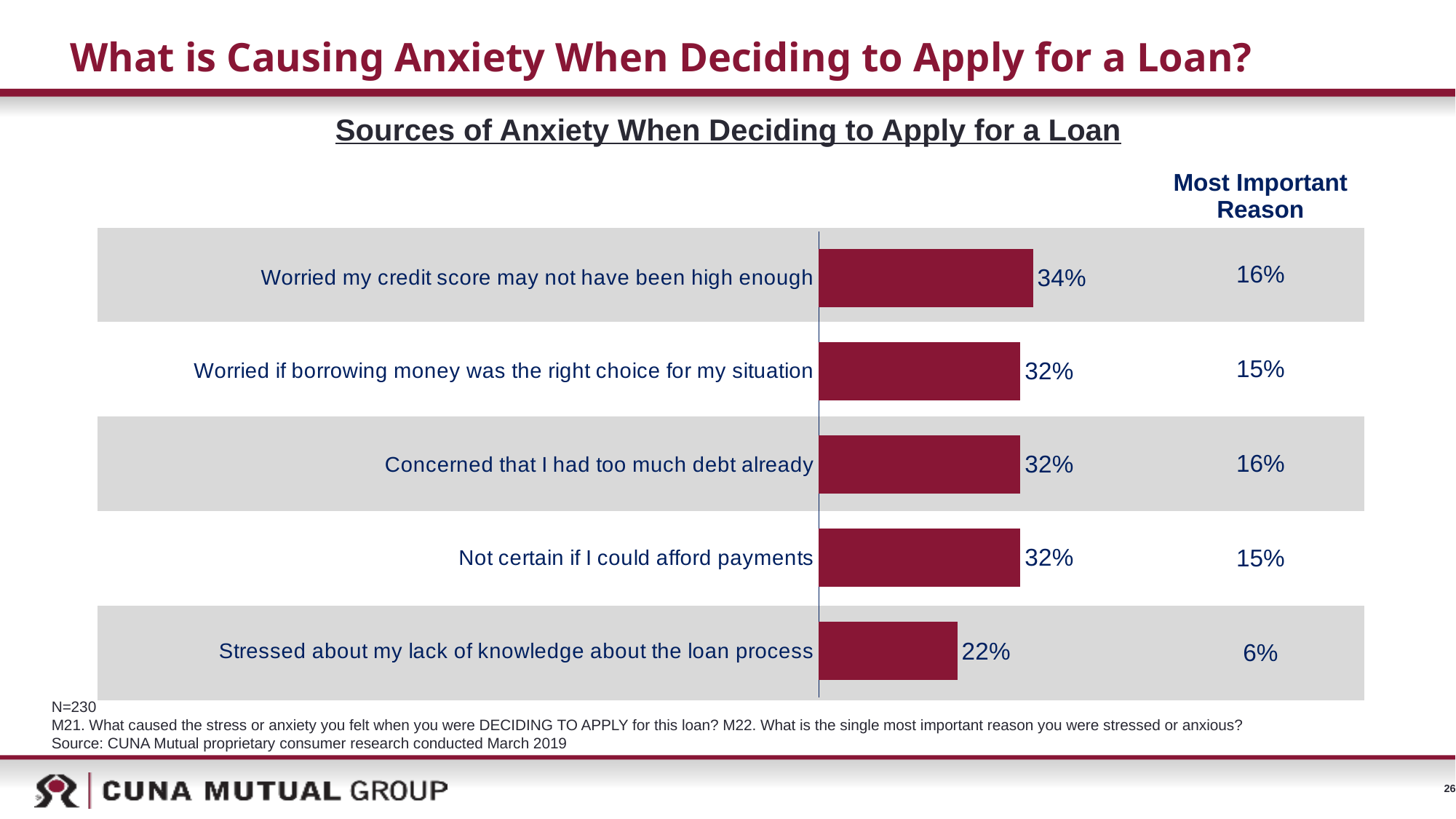
What is the 'Most Important Reason' value for 'Stressed about my lack of knowledge about the loan process'? 6% Which is larger: the bar value for 'Not certain if I could afford payments' or for 'Stressed about my lack of knowledge about the loan process'? Not certain if I could afford payments Which source of anxiety has the lowest percentage in the bar chart? Stressed about my lack of knowledge about the loan process What percentage of respondents were stressed about their lack of knowledge about the loan process? 22% What is the difference between the bar values for 'Worried my credit score may not have been high enough' and 'Stressed about my lack of knowledge about the loan process'? 12 percentage points Which source of anxiety has the highest percentage in the bar chart? Worried my credit score may not have been high enough What is the sample size (N) noted below the chart? N=230 What is the title of the chart? Sources of Anxiety When Deciding to Apply for a Loan How many sources of anxiety are shown in the bar chart? 5 What type of chart is shown on the slide? Bar chart What is the 'Most Important Reason' value for 'Concerned that I had too much debt already'? 16% What percentage of respondents were worried their credit score may not have been high enough? 34%